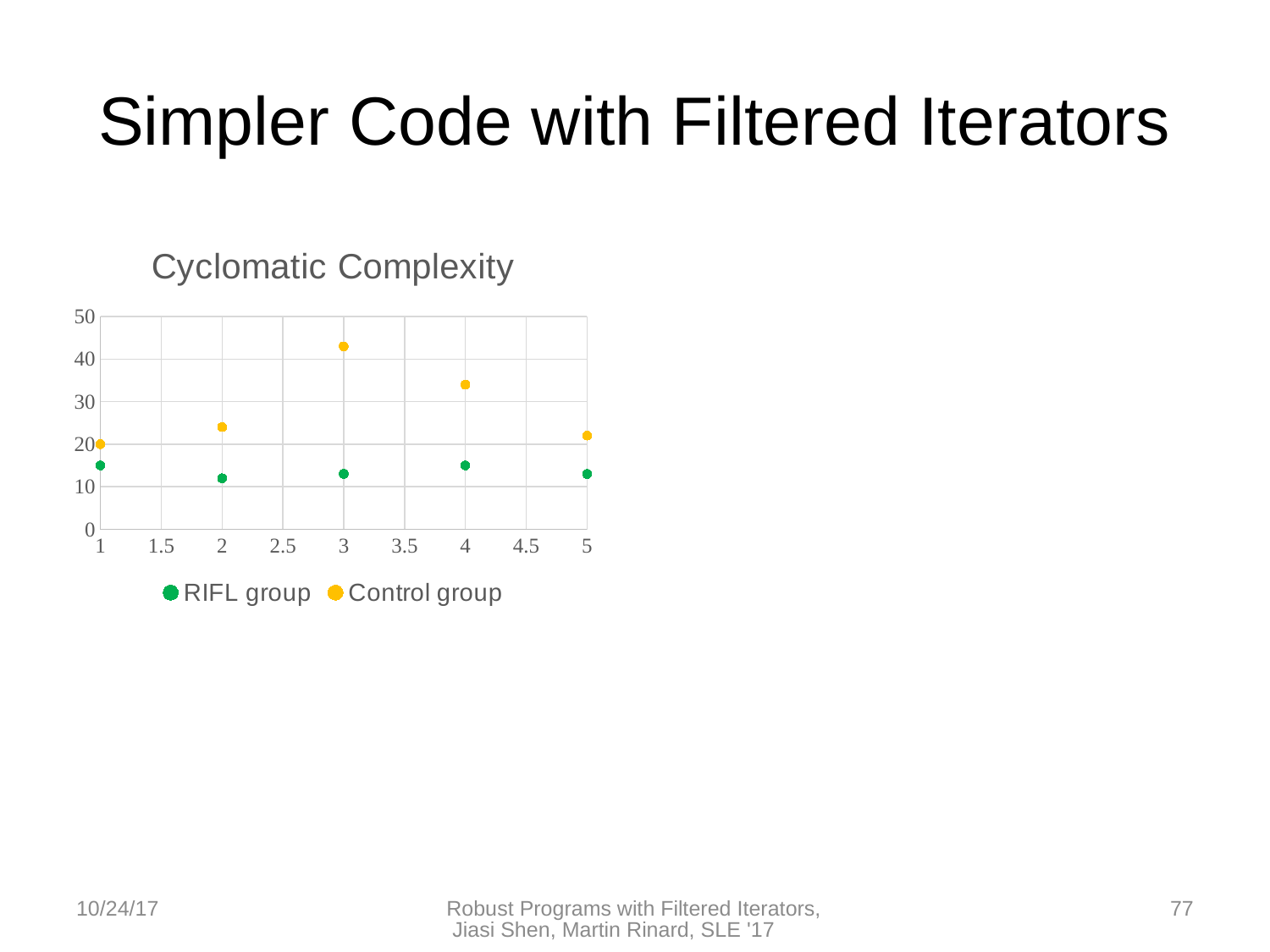
Is the RIFL group value at x = 3 greater or less than 20? less Which series is shown in green? RIFL group At which x value does the Control group reach its highest value? 3 How many points are plotted for the Control group series? 5 Is the Control group value at x = 3 greater or less than 40? greater For the Control group, which is larger, the value at x = 2 or the value at x = 4? x = 4 Is the RIFL group value at x = 2 greater or less than 20? less How many series does the legend list? 2 At x = 3, which series has the larger value, RIFL group or Control group? Control group What kind of chart is shown on the slide? scatter chart What is the title of the chart? Cyclomatic Complexity